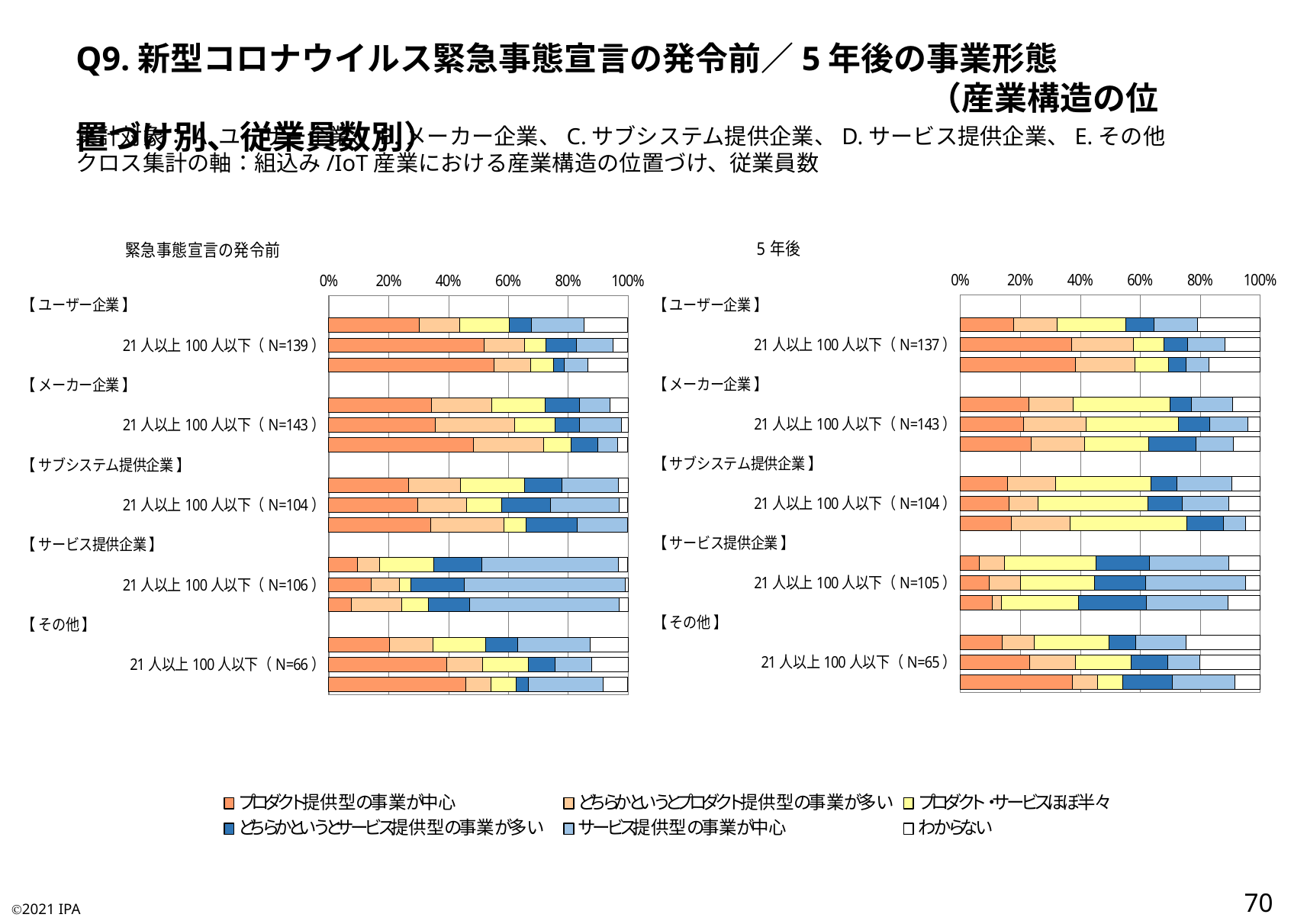
In the left chart (緊急事態宣言の発令前), for the 21人以上100人以下 rows, which has the larger プロダクト提供型の事業が中心 share: 【ユーザー企業】 (N=139) or 【サービス提供企業】 (N=106)? ユーザー企業 In the right chart (5年後), what is the N shown for the 21人以上100人以下 row under 【その他】? N=65 Which legend entry is shown with a white (unfilled) marker? わからない How many series does the legend at the bottom of the slide list? 6 What kind of chart is the left chart titled 緊急事態宣言の発令前? stacked bar chart In the left chart (緊急事態宣言の発令前), is the プロダクト提供型の事業が中心 share for the 21人以上100人以下 (N=106) row under 【サービス提供企業】 greater or less than 20%? less How many industry-position groups (e.g. 【ユーザー企業】) are listed on the left chart? 5 For the 21人以上100人以下 row under 【ユーザー企業】, is the プロダクト提供型の事業が中心 share larger in the left chart (緊急事態宣言の発令前) or the right chart (5年後)? 緊急事態宣言の発令前 In the right chart (5年後), is the プロダクト提供型の事業が中心 share for the 21人以上100人以下 (N=137) row under 【ユーザー企業】 greater or less than 20%? greater What is the title of the right-hand chart? 5年後 In the left chart (緊急事態宣言の発令前), is the プロダクト提供型の事業が中心 share for the 21人以上100人以下 (N=139) row under 【ユーザー企業】 greater or less than 40%? greater In the left chart (緊急事態宣言の発令前), what is the N shown for the 21人以上100人以下 row under 【サービス提供企業】? N=106